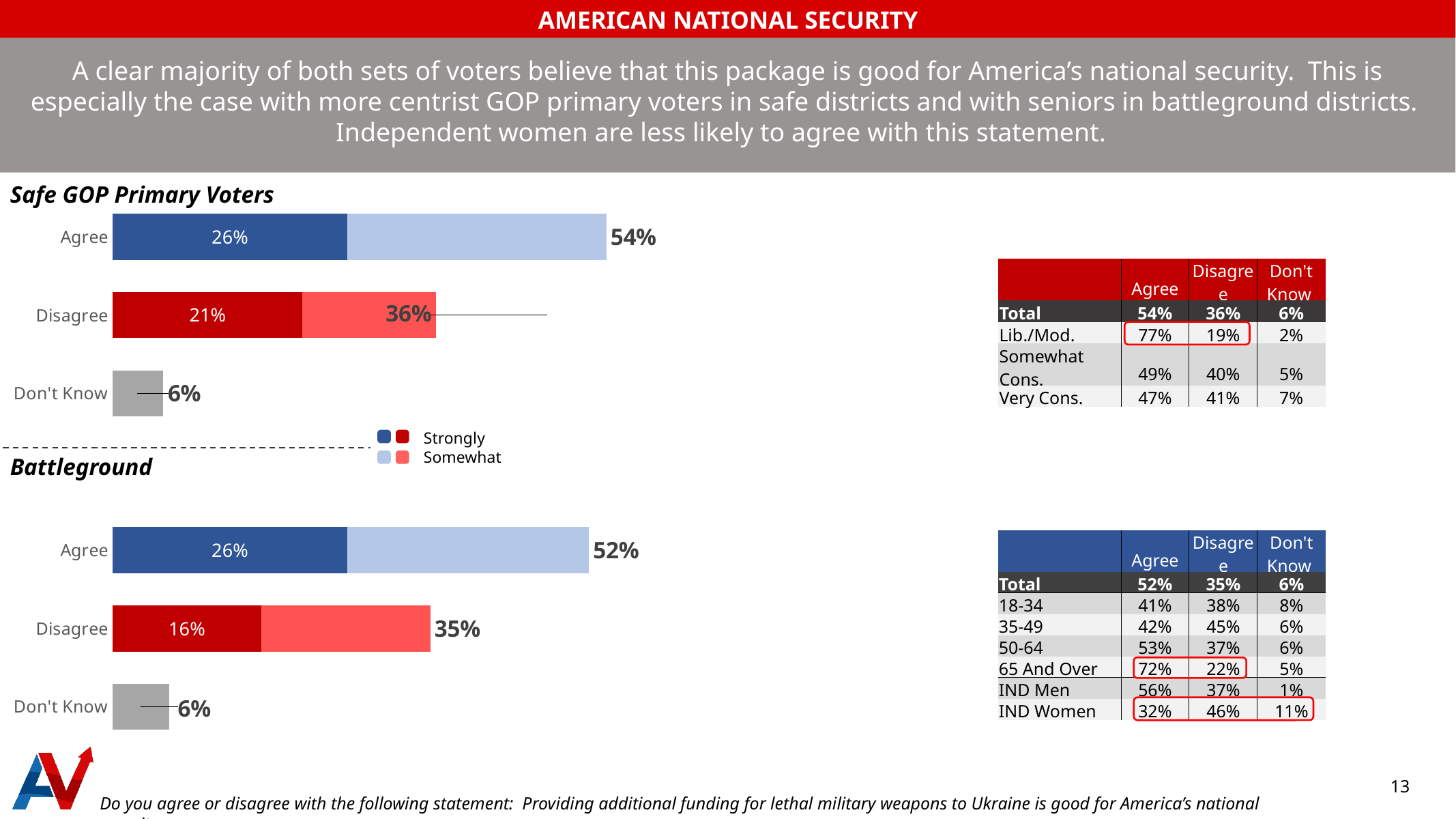
How many series does the legend list for the charts? 2 In the Battleground chart, what is the difference between the total Agree and total Disagree percentages? 17% In the Battleground chart, what is the total percentage for Disagree? 35% In the Safe GOP Primary Voters chart, which category has the highest total value? Agree Is the total Agree value larger in the Safe GOP Primary Voters chart or the Battleground chart? Safe GOP Primary Voters In the Battleground chart, what is the value for Don't Know? 6% In the Battleground chart, which category has the lowest value? Don't Know What type of chart is the Battleground chart? Stacked bar chart In the Safe GOP Primary Voters chart, what is the total percentage for Agree? 54% In the Battleground chart, what percentage strongly agree? 26% In the Safe GOP Primary Voters chart, what percentage strongly disagree? 21% In the Safe GOP Primary Voters chart, what is the difference between the total Agree and total Disagree percentages? 18%